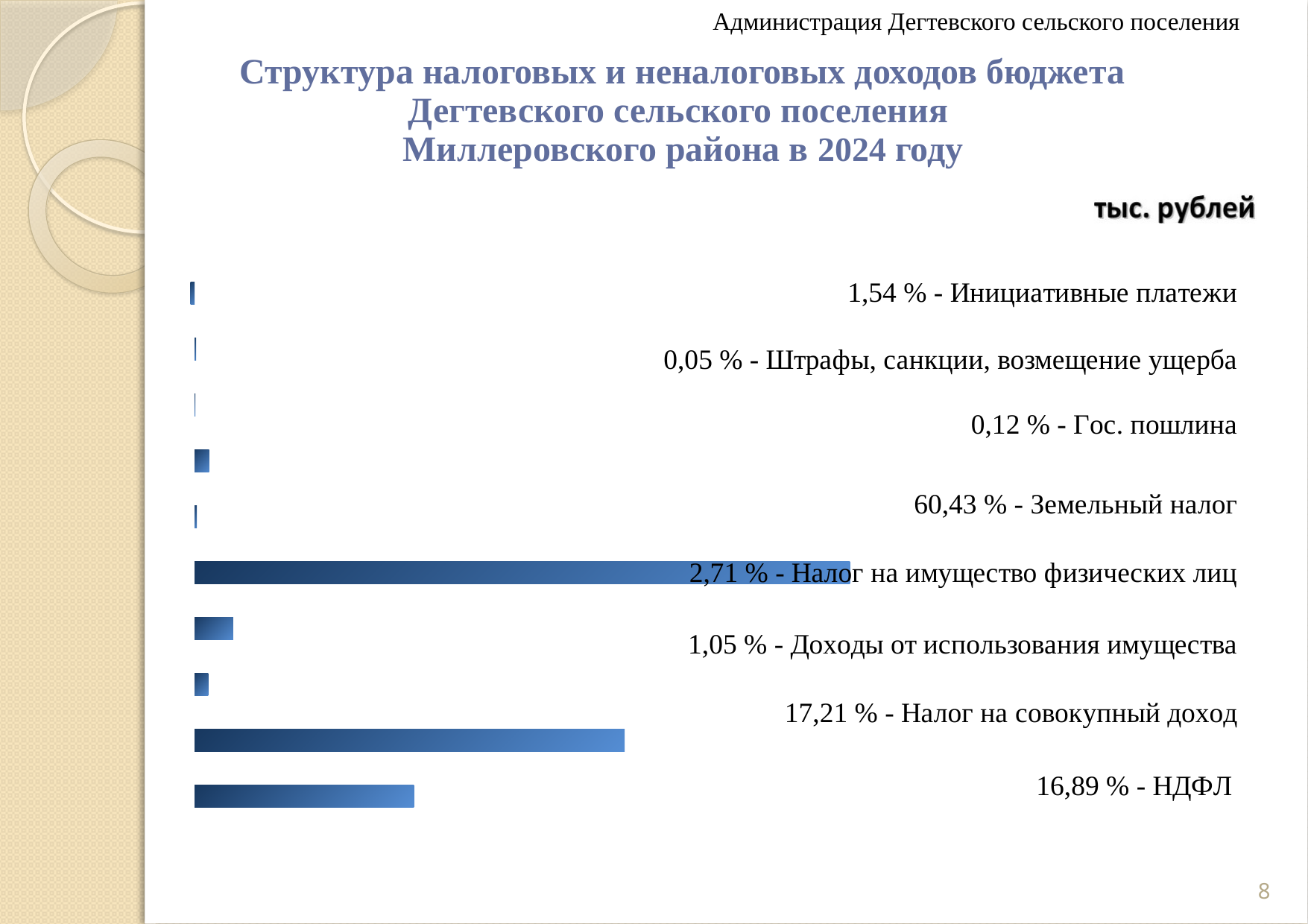
Which has the larger share, Налог на совокупный доход or НДФЛ? Налог на совокупный доход What share is listed for НДФЛ? 16,89 % What kind of chart is shown on the slide? bar chart What year does the chart title refer to? 2024 How many bars does the chart contain? 10 What share is listed for Земельный налог? 60,43 % What unit is indicated above the chart? тыс. рублей What share is listed for Налог на совокупный доход? 17,21 % What share is listed for Инициативные платежи? 1,54 % Which listed revenue source has the smallest share? Штрафы, санкции, возмещение ущерба What is the difference between the shares of Налог на имущество физических лиц and Доходы от использования имущества? 1,66 % Which listed revenue source has the largest share? Земельный налог